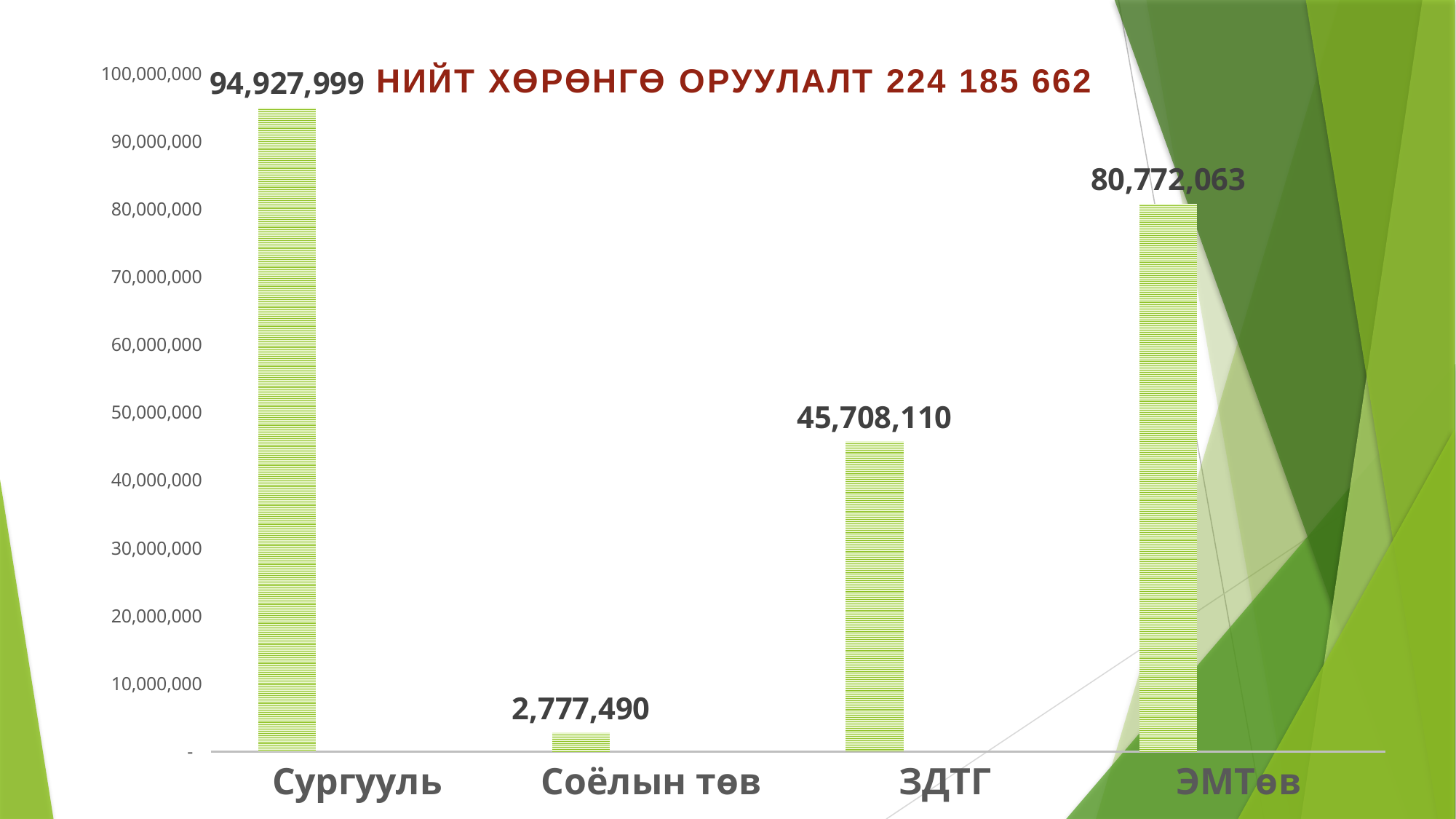
What is the value for ЭМТөв? 80,772,063 What is the value for Соёлын төв? 2,777,490 Which category has the highest value? Сургууль What is the difference between the values for ЗДТГ and Соёлын төв? 42,930,620 What total investment figure is stated in the chart title? 224 185 662 Which category has the lowest value? Соёлын төв What is the difference between the values for Сургууль and ЭМТөв? 14,155,936 What is the value for Сургууль? 94,927,999 How many categories are shown on the x axis? 4 What kind of chart is shown on the slide? Bar chart Which is larger, the value for ЗДТГ or the value for ЭМТөв? ЭМТөв What is the value for ЗДТГ? 45,708,110